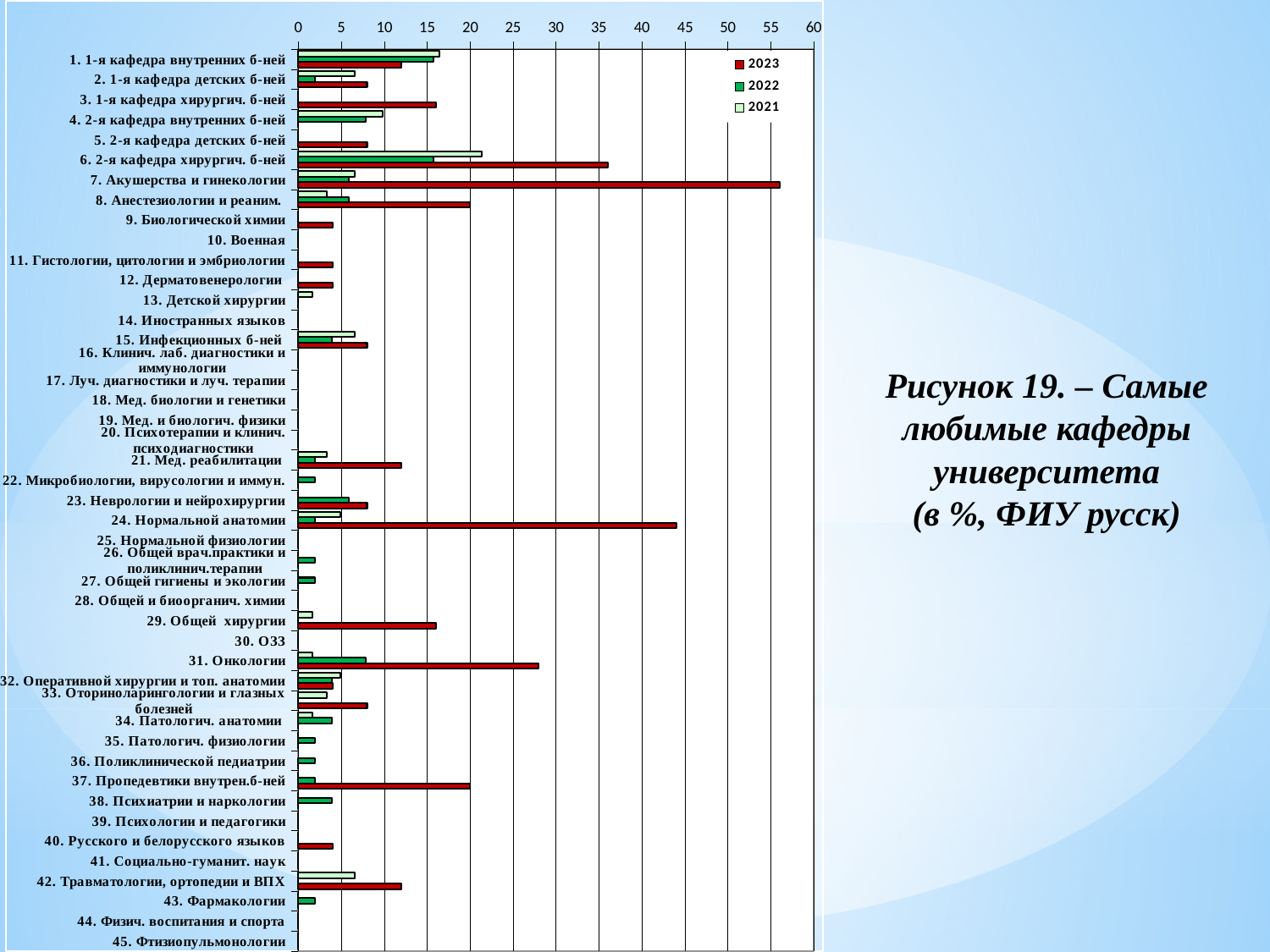
Is the 2023 value for "31. Онкологии" greater or less than 25? greater Which is larger for 2023: "31. Онкологии" or "21. Мед. реабилитации"? 31. Онкологии Which is larger for 2023: "7. Акушерства и гинекологии" or "24. Нормальной анатомии"? 7. Акушерства и гинекологии Which years are listed in the legend? 2023, 2022, 2021 Is the 2023 value for "24. Нормальной анатомии" greater or less than 40? greater How many departments (categories) are listed on the chart? 45 Is the 2023 value for "1. 1-я кафедра внутренних б-ней" greater or less than 15? less What kind of chart is shown on the slide? bar chart Which department has the highest 2023 value? 7. Акушерства и гинекологии How many series does the legend list? 3